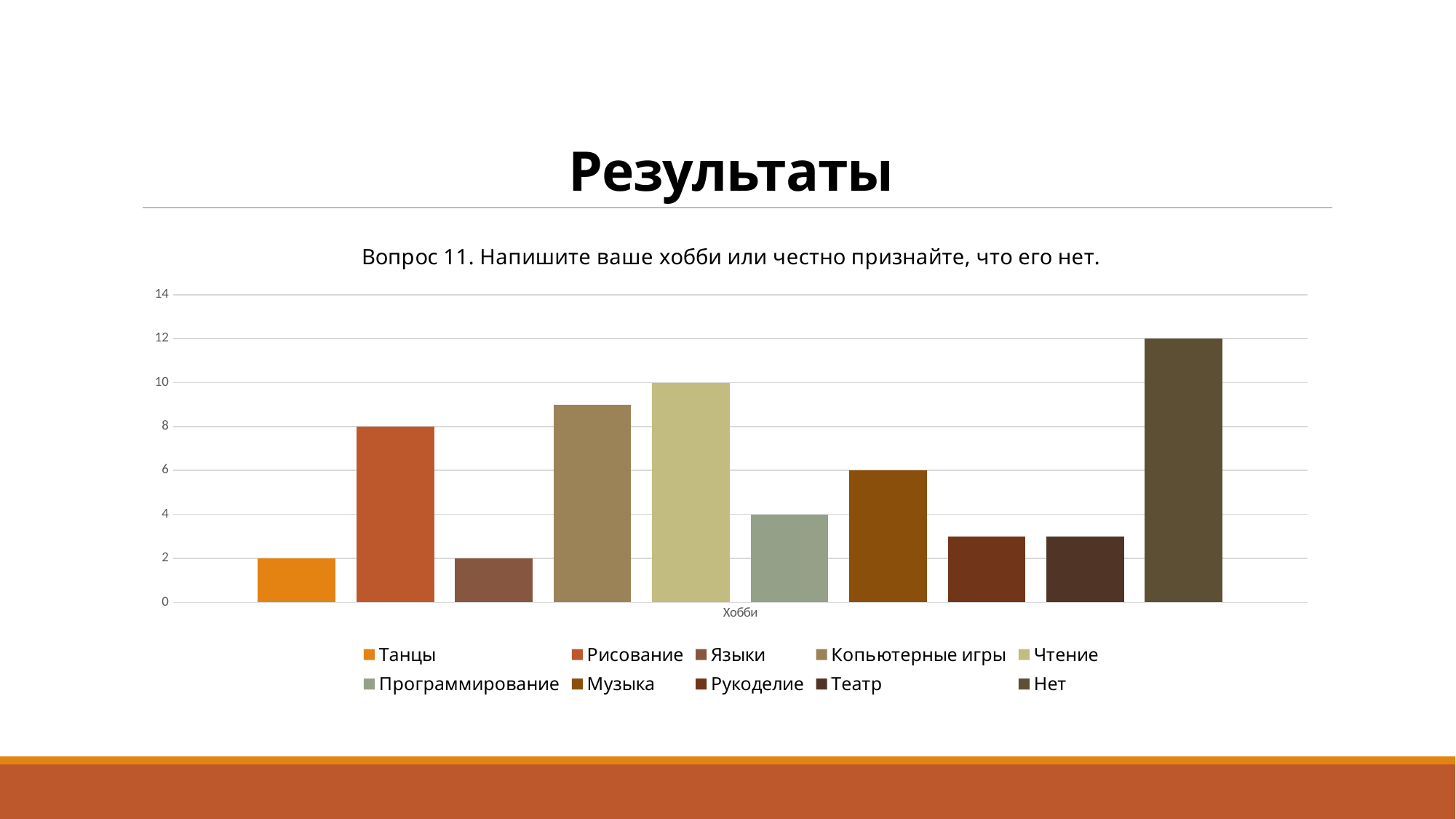
Which series has the highest bar? Нет How many series does the legend list? 10 Is the value for Рукоделие greater or less than 4? less What is the difference between the values for Нет and Чтение? 2 What is the value for Рисование? 8 What is the value for Музыка? 6 What is the value for Чтение? 10 What is the value for Нет? 12 What is the value for Программирование? 4 Is the value for Копьютерные игры greater or less than 8? greater Which is larger, the value for Чтение or the value for Рисование? Чтение What type of chart is shown on the slide? bar chart